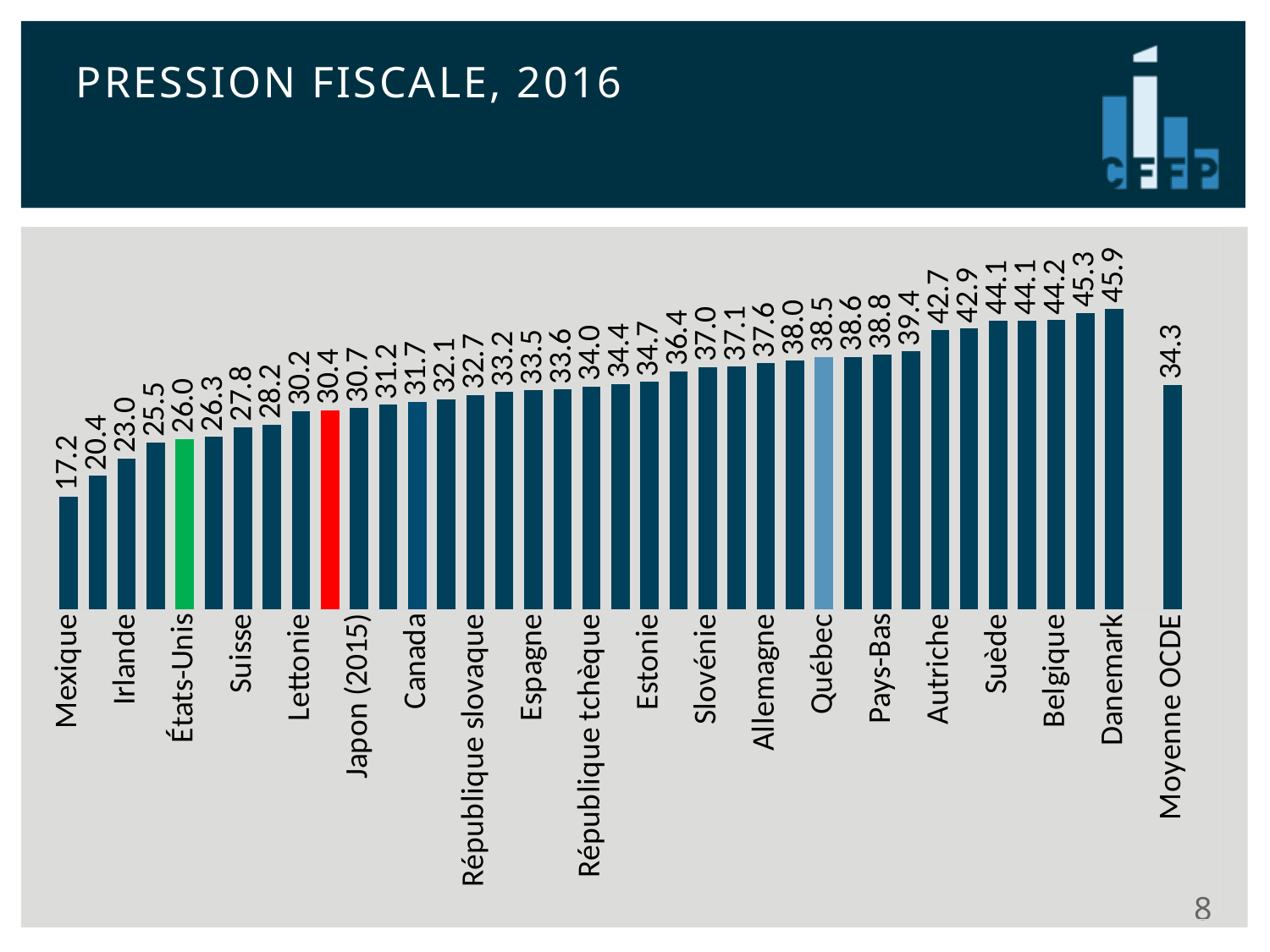
What is the value for Danemark? 45.9 What colour is the bar for États-Unis? Green Do the country values rise or fall from left to right across the chart (excluding Moyenne OCDE)? Rise What kind of chart is shown on the slide? Bar chart What is the value for Canada? 31.7 What is the value for Mexique? 17.2 Which is larger, the value for Québec or the value for Moyenne OCDE? Québec Which country has the lowest value on the chart? Mexique What is the value for Québec? 38.5 What is the difference between the values for Québec and Canada? 6.8 What is the value for Moyenne OCDE? 34.3 Which country has the highest value on the chart? Danemark